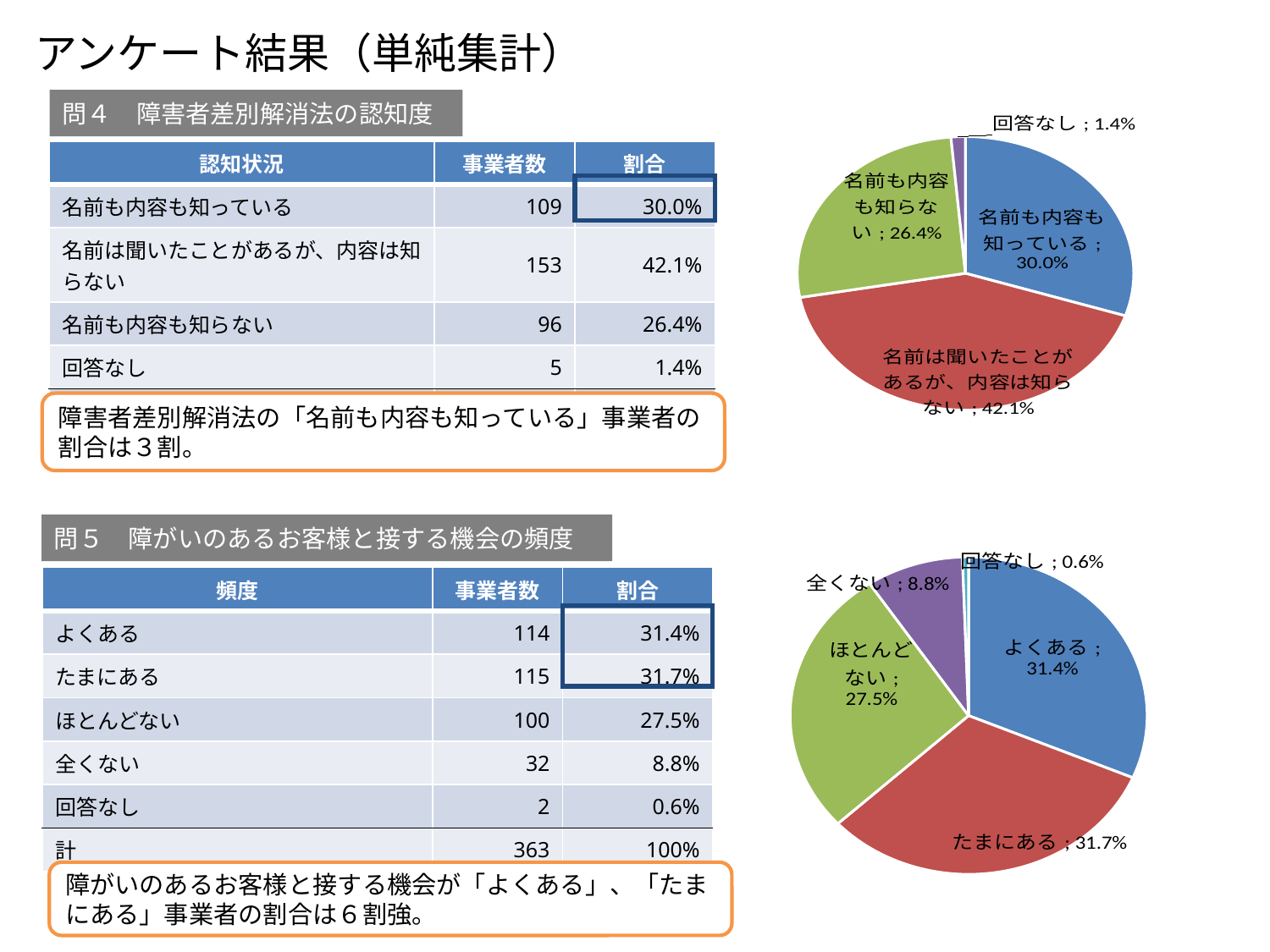
In the top pie chart (問4), what is the difference between the shares for 名前も内容も知っている and 名前も内容も知らない? 3.6% What kind of chart is shown at the bottom right of the slide (問5)? Pie chart In the bottom pie chart (問5), which is larger: the slice for ほとんどない or the slice for 全くない? ほとんどない In the top pie chart (問4), which category has the largest slice? 名前は聞いたことがあるが、内容は知らない In the top pie chart (問4), which category has the smallest slice? 回答なし In the top pie chart (問4), what share is labelled for 名前は聞いたことがあるが、内容は知らない? 42.1% In the bottom pie chart (問5), what share is labelled for ほとんどない? 27.5% In the bottom pie chart (問5), which category has the smallest slice? 回答なし In the bottom pie chart (問5), what share is labelled for 全くない? 8.8% In the top pie chart (問4), what share is labelled for 名前も内容も知っている? 30.0% In the bottom pie chart (問5), how many slices does the pie have? 5 In the top pie chart (問4), how many slices does the pie have? 4